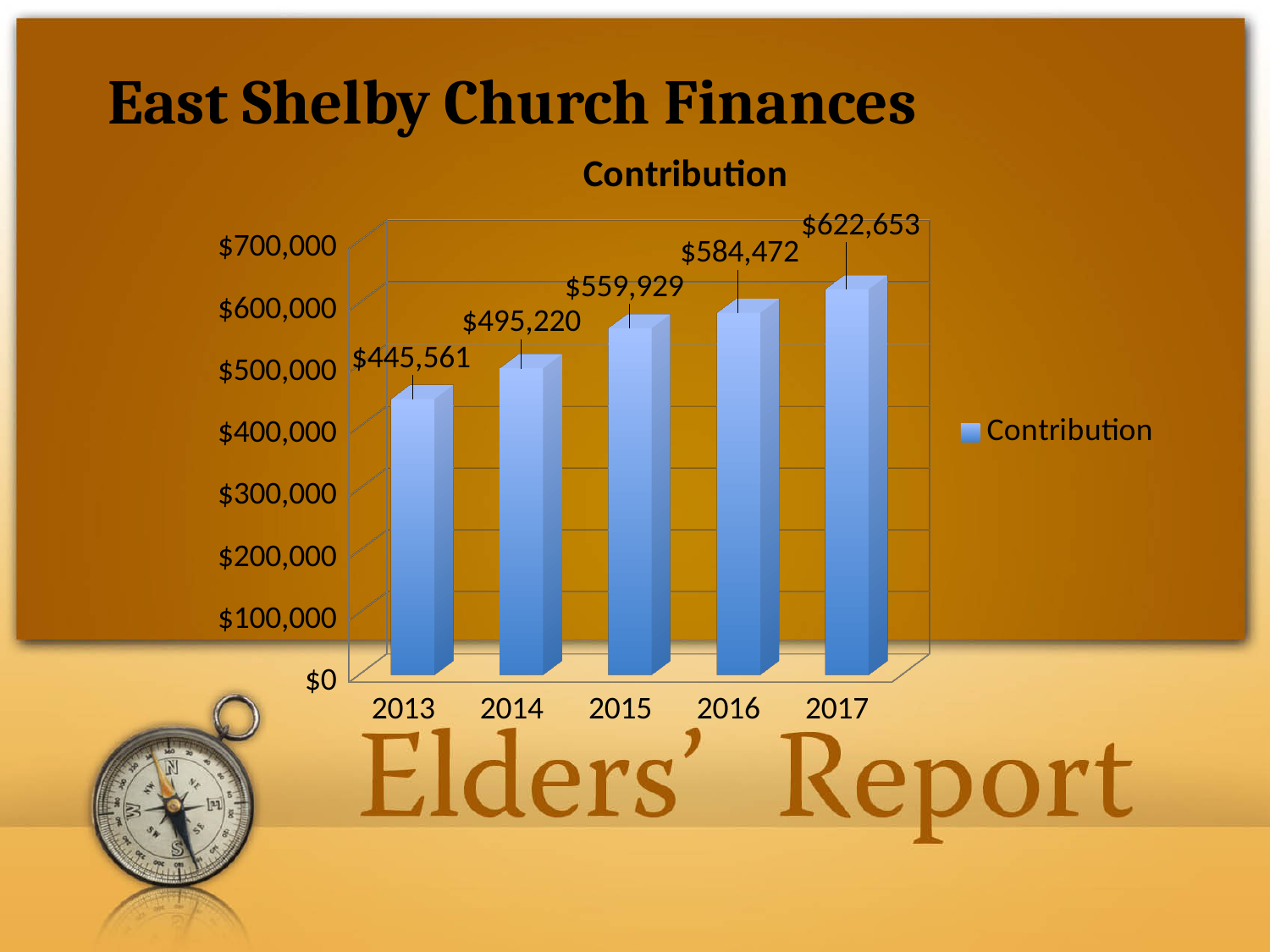
How many series does the legend list? 1 What was the contribution in 2017? $622,653 What kind of chart is shown on the slide? Bar chart Do contributions rise or fall from 2013 to 2017? Rise Which year had a larger contribution, 2014 or 2016? 2016 Which year had the highest contribution? 2017 How many years are shown in the chart? 5 What was the contribution in 2015? $559,929 What was the contribution in 2013? $445,561 Which year had the lowest contribution? 2013 What is the difference between the 2014 and 2013 contributions? $49,659 What is the difference between the 2017 and 2016 contributions? $38,181